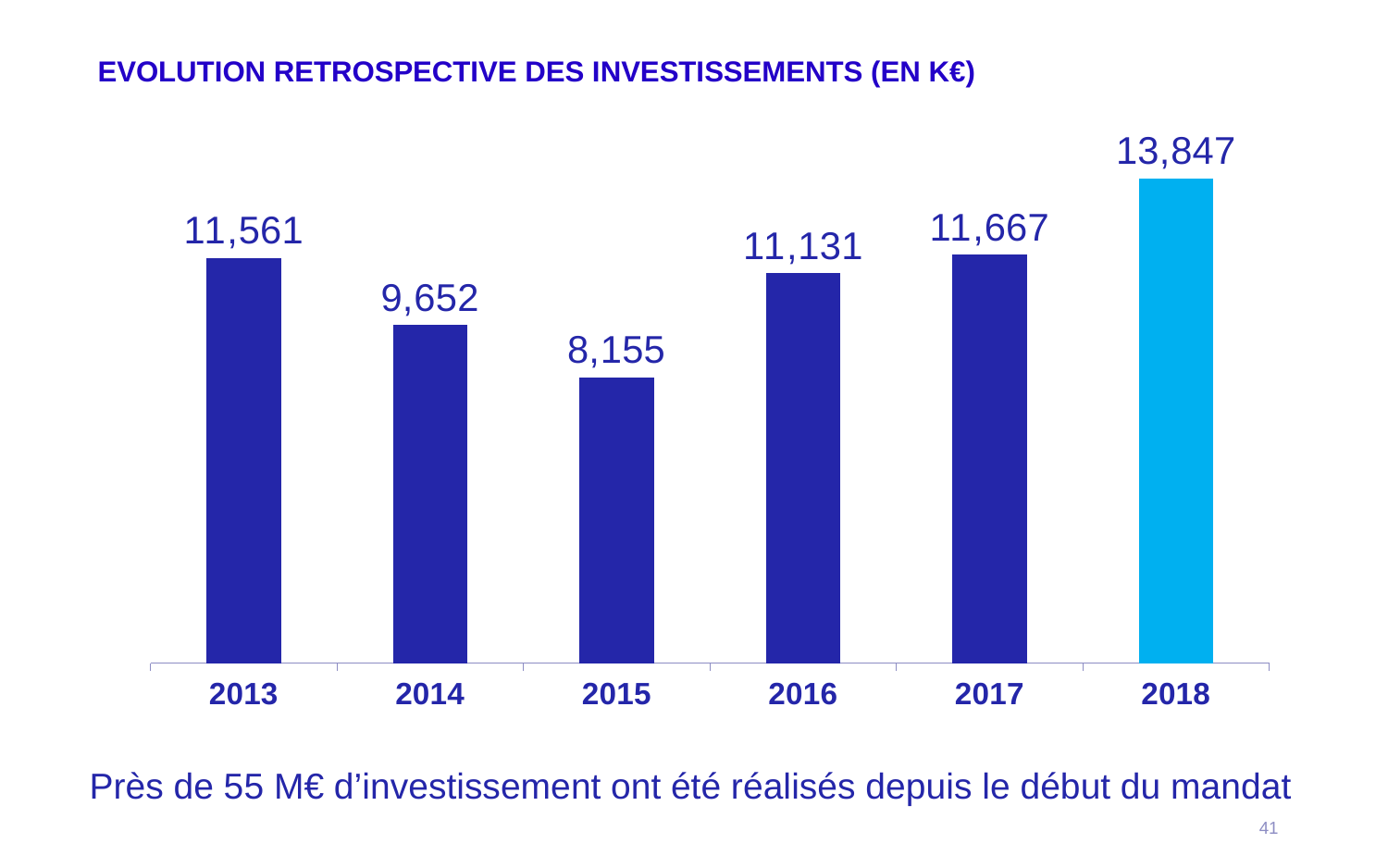
What is the value for 2014? 9,652 What is the value for 2018? 13,847 Which bar is shown in a different colour from the others? 2018 What is the value for 2015? 8,155 What is the difference between the values for 2018 and 2017? 2,180 What is the difference between the values for 2013 and 2014? 1,909 Which year has the lowest value? 2015 Do the values rise or fall from 2015 to 2018? rise How many years are shown on the chart? 6 Which year has the highest value? 2018 What kind of chart is shown on the slide? bar chart Which is larger, the value for 2013 or the value for 2016? 2013